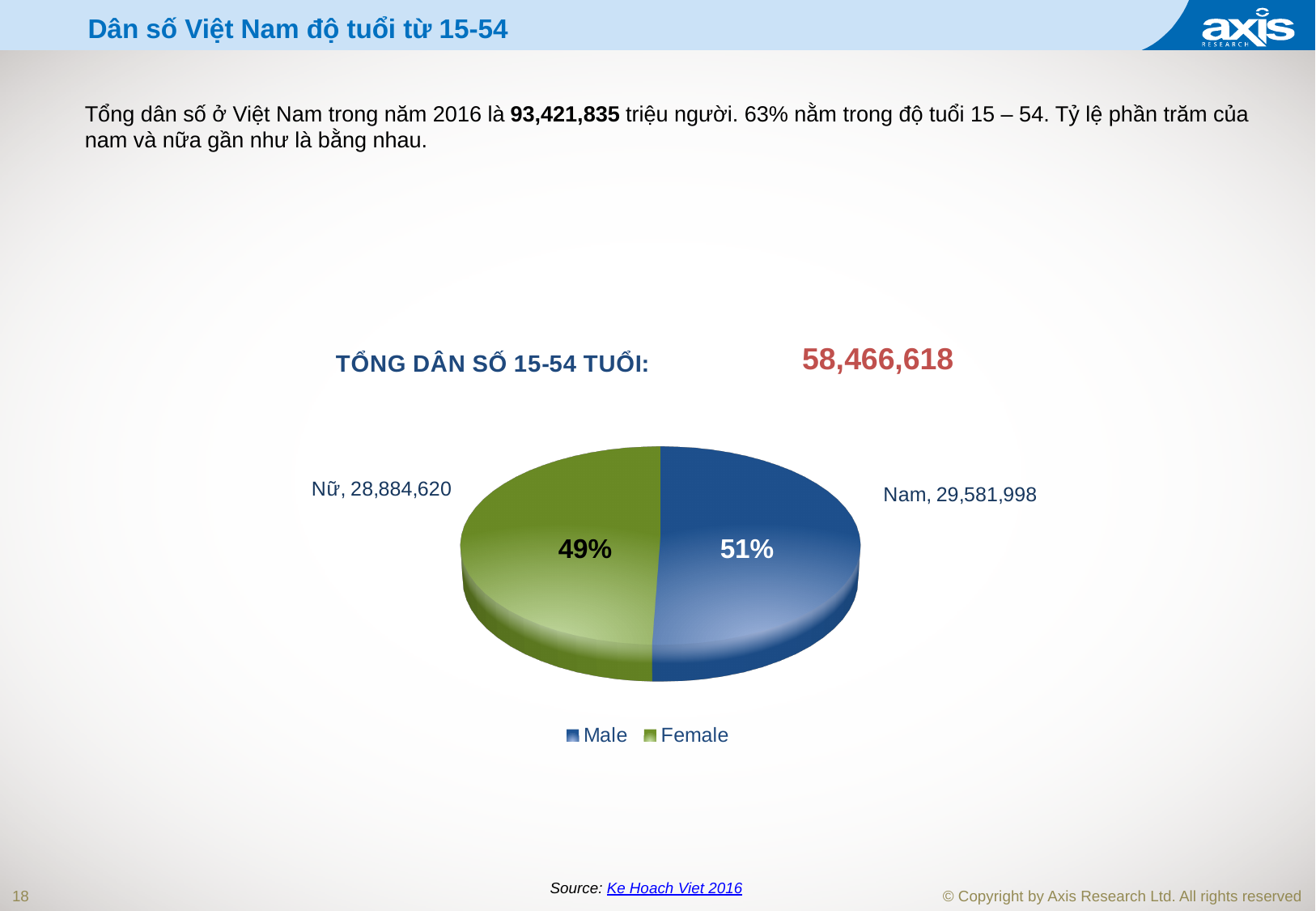
What is the total of the two slices in the pie chart? 58,466,618 How many entries does the chart legend list? 2 What is the value for Nam (Male) in the pie chart? 29,581,998 What percentage share of the pie does the Female slice have? 49% Which slice of the pie chart is larger, Nam or Nữ? Nam What is the value for Nữ (Female) in the pie chart? 28,884,620 How many slices does the pie chart have? 2 Which category has the smallest slice in the pie chart? Nữ What is the difference between the Nam value and the Nữ value? 697,378 What colour is the Female slice in the pie chart? green What percentage share of the pie does the Male slice have? 51% What kind of chart is shown on the slide? pie chart